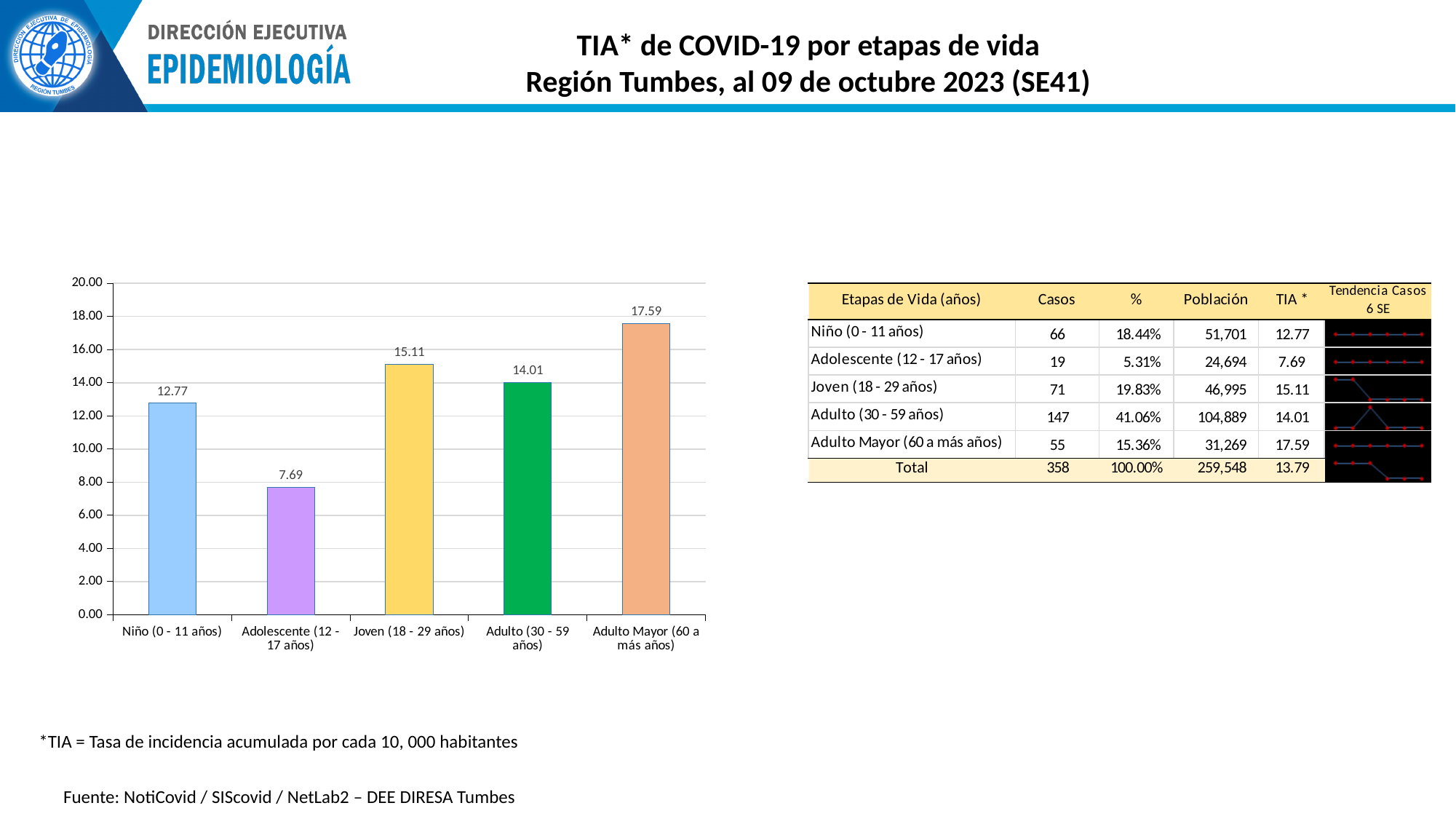
What is the TIA value for Adolescente (12 - 17 años) in the bar chart? 7.69 Which life stage has the highest TIA in the bar chart? Adulto Mayor (60 a más años) How many life-stage categories are shown in the bar chart? 5 What colour is the bar for Adulto (30 - 59 años)? green Which life stage has the lowest TIA in the bar chart? Adolescente (12 - 17 años) What kind of chart is used to show TIA by life stage? bar chart What is the difference between the TIA for Joven (18 - 29 años) and Adolescente (12 - 17 años)? 7.42 What is the TIA value for Niño (0 - 11 años) in the bar chart? 12.77 What is the TIA value for Joven (18 - 29 años) in the bar chart? 15.11 Is the TIA value for Adulto (30 - 59 años) greater or less than 12.00? greater Which has a higher TIA: Joven (18 - 29 años) or Adulto (30 - 59 años)? Joven (18 - 29 años) What is the difference between the TIA for Adulto Mayor (60 a más años) and Niño (0 - 11 años)? 4.82